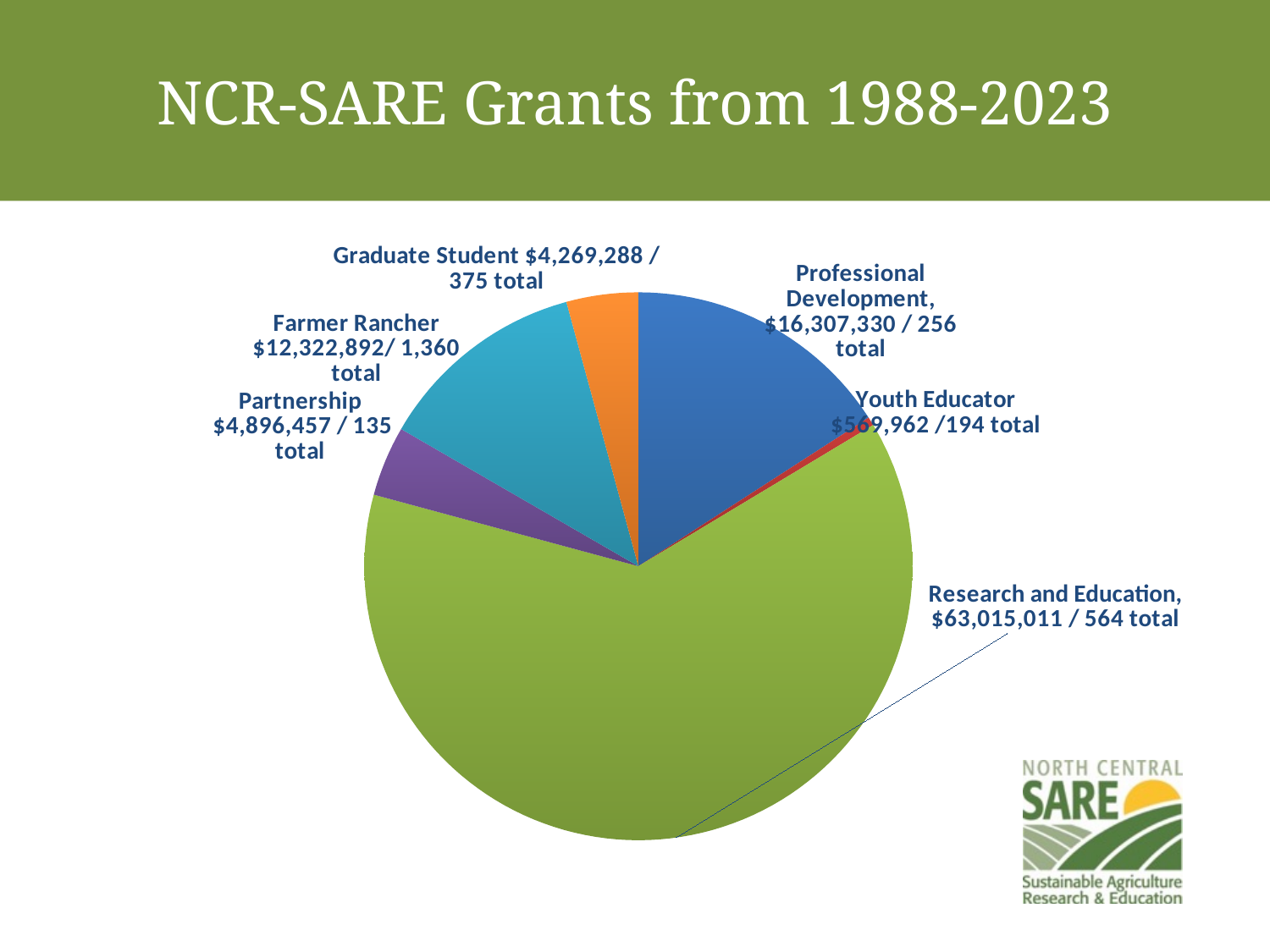
What is the dollar amount shown for Professional Development? $16,307,330 Which category has the largest slice of the pie? Research and Education What is the difference in dollar amount between Professional Development and Partnership? $11,410,873 Which has a larger dollar amount, Farmer Rancher or Professional Development? Professional Development Which category has the smallest slice of the pie? Youth Educator What is the dollar amount shown for Partnership? $4,896,457 How many total grants are shown for Farmer Rancher? 1,360 How many total grants are shown for Graduate Student? 375 What is the dollar amount shown for Research and Education? $63,015,011 How many categories (slices) does the pie chart show? 6 What is the title of the slide's chart? NCR-SARE Grants from 1988-2023 What kind of chart is shown on the slide? Pie chart